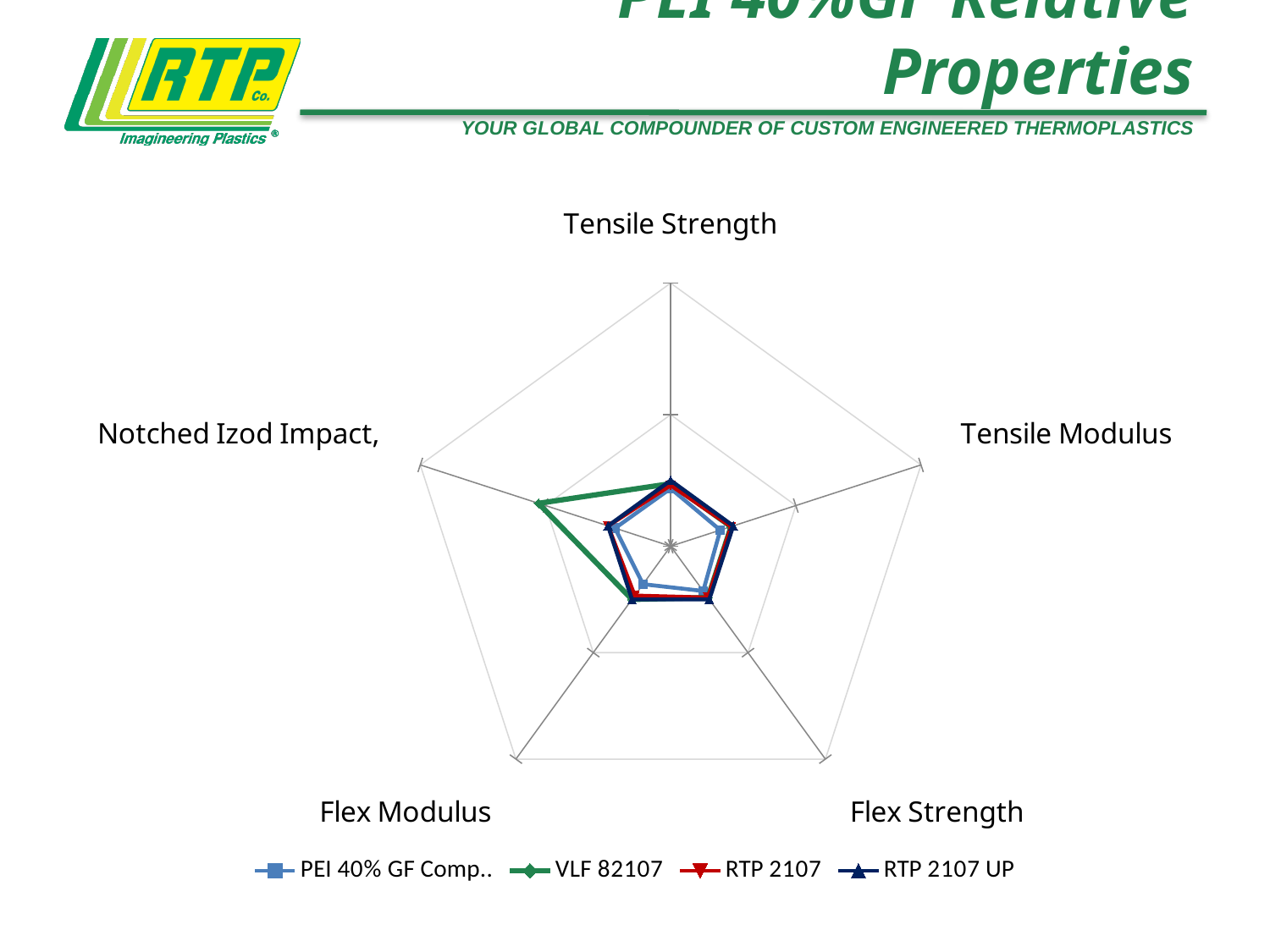
For Notched Izod Impact, which is larger: VLF 82107 or PEI 40% GF Comp..? VLF 82107 What kind of chart is shown on the slide? Radar chart For Flex Modulus, which is larger: VLF 82107 or PEI 40% GF Comp..? VLF 82107 Which series has the lowest value for Tensile Modulus? PEI 40% GF Comp.. Which series has the highest value for Notched Izod Impact? VLF 82107 Which series has the lowest value for Flex Strength? PEI 40% GF Comp.. Which category is plotted on the axis at the top of the radar chart? Tensile Strength How many property categories (axes) does the radar chart have? 5 What colour is used for the VLF 82107 series? Green How many series does the legend list? 4